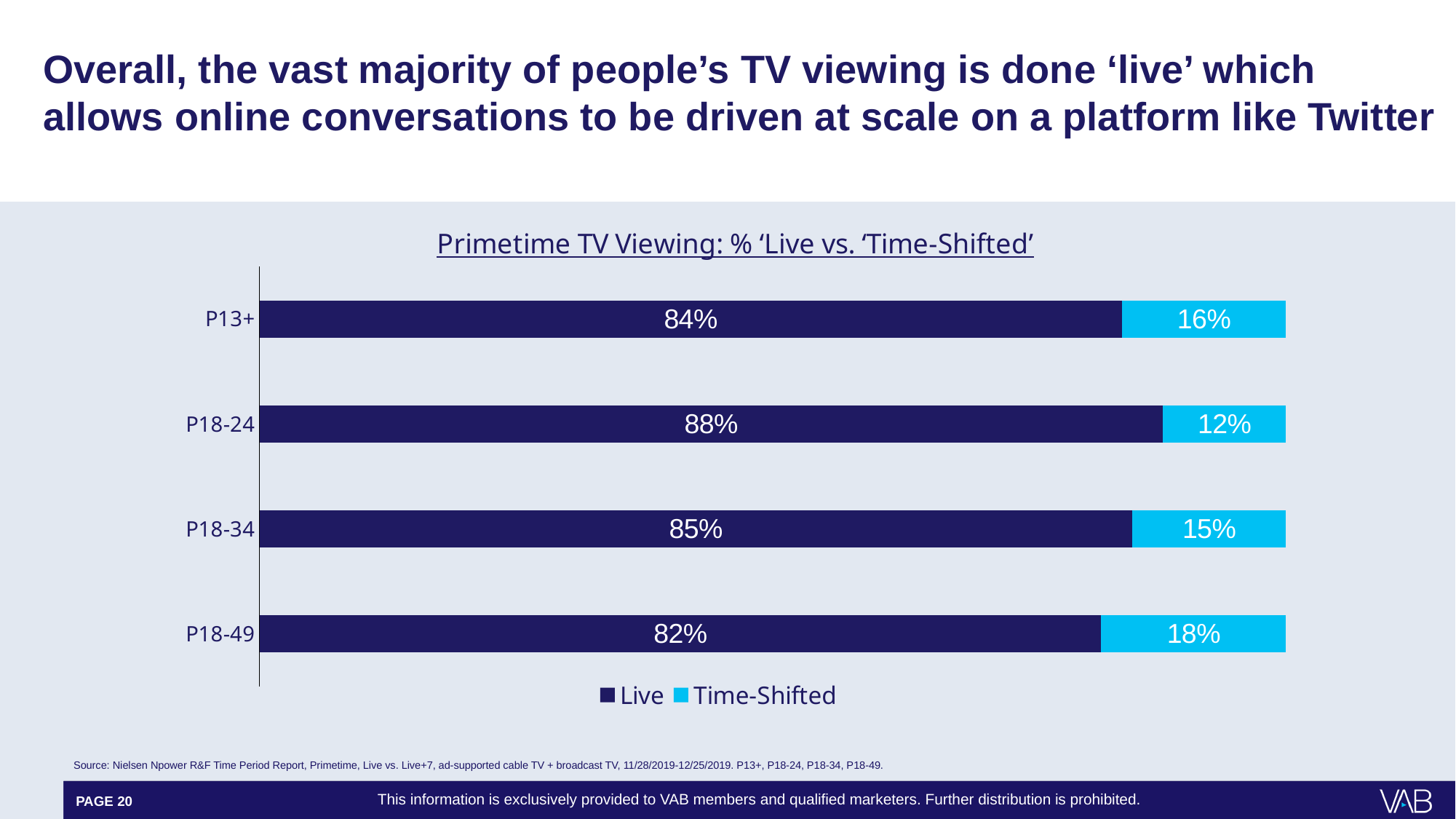
What kind of chart is shown? Stacked bar chart Which category has the lowest Time-Shifted value? P18-24 How many series does the legend list? 2 Which category has the highest Live value? P18-24 What is the Live value for P18-24? 88% What is the Time-Shifted value for P18-34? 15% Which is larger, the Time-Shifted value for P13+ or for P18-34? P13+ What is the Time-Shifted value for P18-49? 18% What is the title of the chart? Primetime TV Viewing: % 'Live vs. 'Time-Shifted' What is the difference between the Live values for P18-24 and P18-49? 6% What is the Live value for P13+? 84% How many categories are shown on the chart? 4